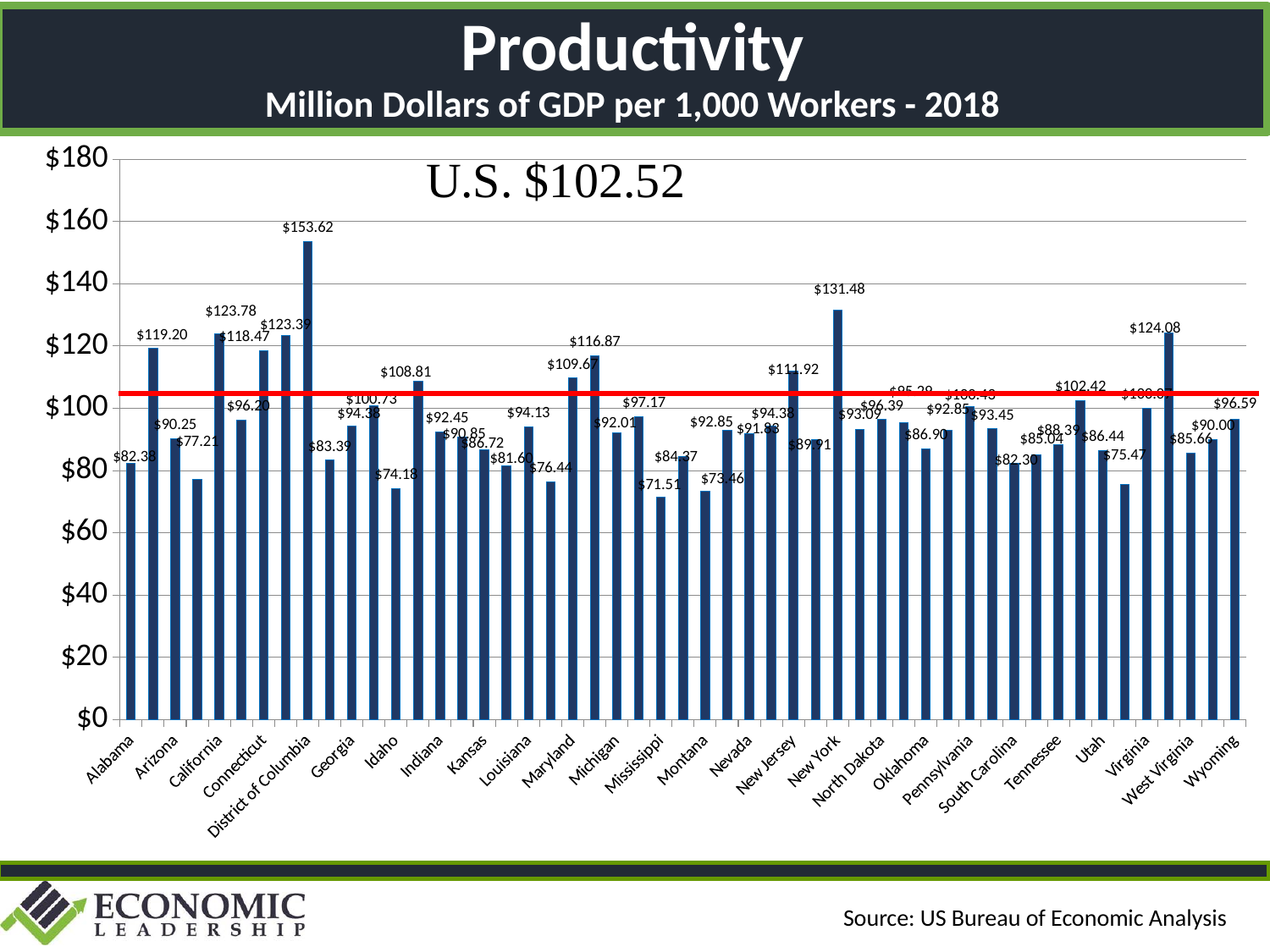
What is the productivity value shown for Mississippi? $71.51 What is the productivity value shown for the District of Columbia? $153.62 Which state or district has the highest productivity value in the chart? District of Columbia What is the difference between the values for New York and California? $7.70 What is the productivity value shown for New York? $131.48 What U.S. value is printed on the chart? $102.52 What kind of chart is shown on the slide? bar chart Which has the larger value, Maryland or New Jersey? New Jersey What is the productivity value shown for Wyoming? $96.59 Which state has the lowest productivity value in the chart? Mississippi What is the difference between the values for the District of Columbia and Alabama? $71.24 Is the value for Idaho greater or less than $80? less